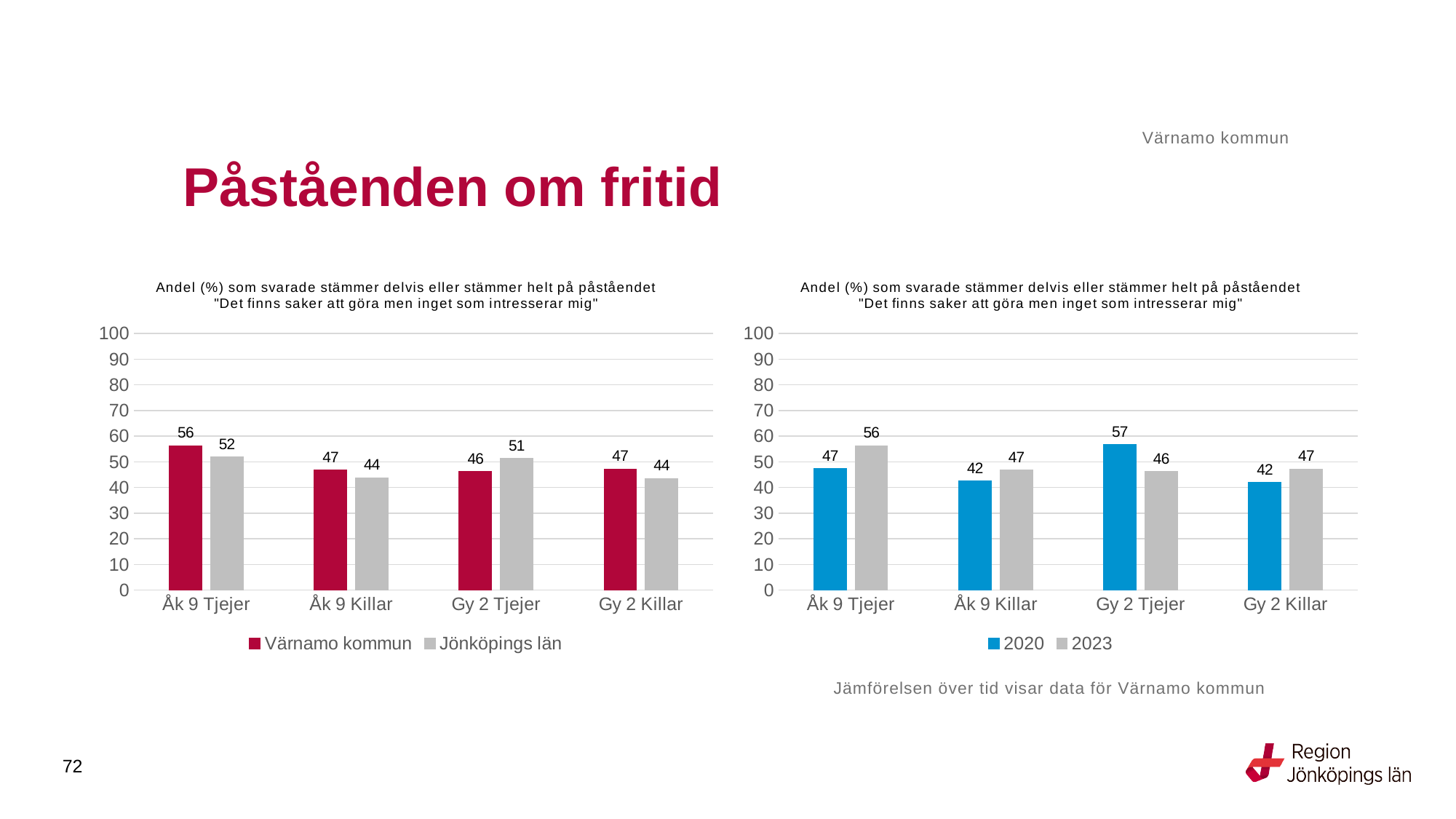
In the right chart, which category has the lowest value for 2023? Gy 2 Tjejer What kind of chart is the left chart? Bar chart In the left chart, which is larger for Gy 2 Tjejer: Värnamo kommun or Jönköpings län? Jönköpings län In the left chart, what is the value for Värnamo kommun for Åk 9 Tjejer? 56 How many categories are shown on the x axis of the left chart? 4 In the right chart, what is the value for 2020 for Gy 2 Tjejer? 57 In the right chart, is the value for 2020 for Gy 2 Killar greater or less than 50? less How many series does the legend of the right chart list? 2 In the left chart, what is the value for Jönköpings län for Gy 2 Tjejer? 51 In the left chart, which category has the highest value for Värnamo kommun? Åk 9 Tjejer In the right chart, what is the value for 2023 for Åk 9 Killar? 47 In the right chart, what is the difference between the 2023 and 2020 values for Åk 9 Tjejer? 9